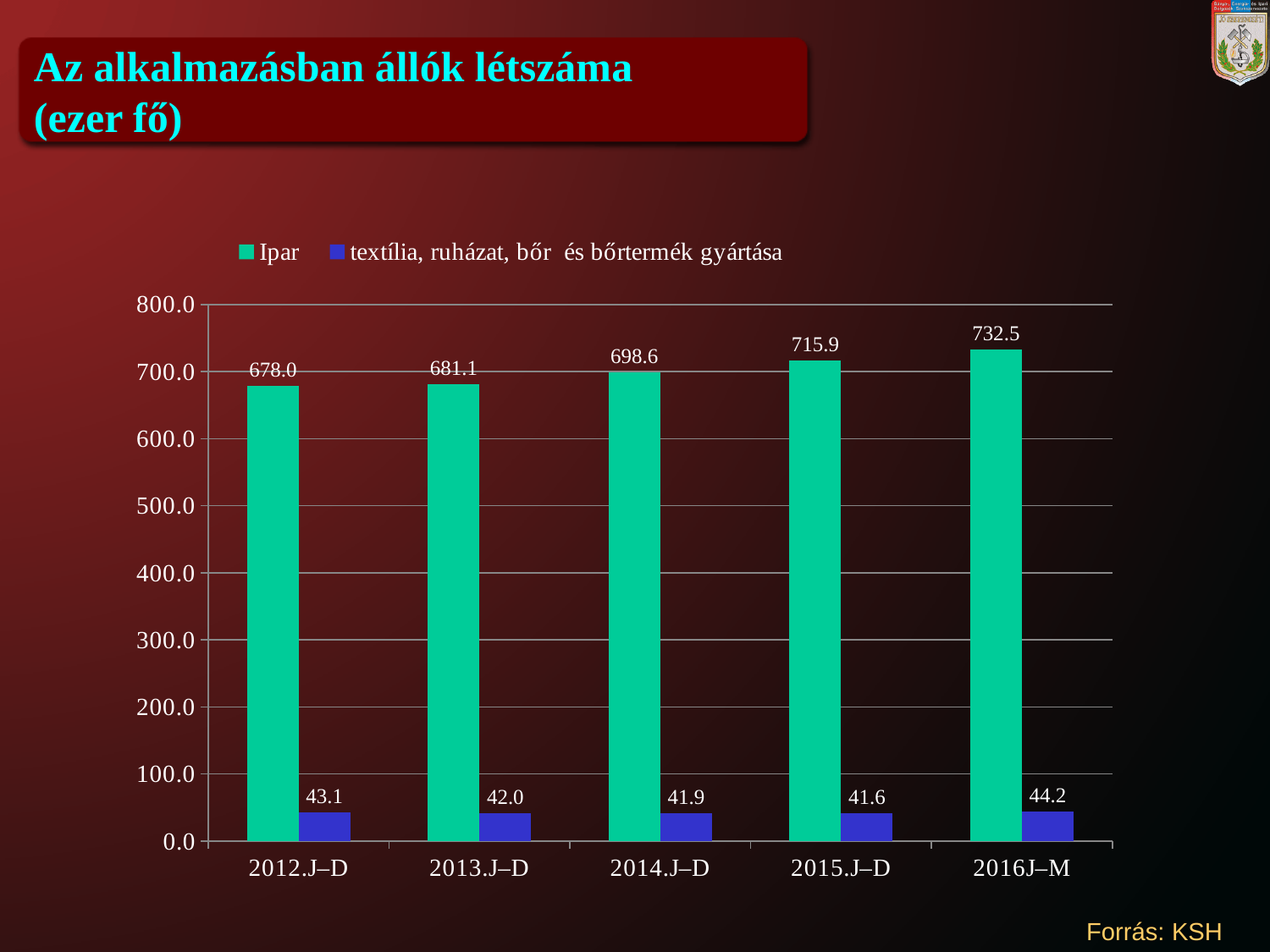
Which is larger, the Ipar value for 2013.J–D or for 2015.J–D? 2015.J–D What kind of chart is shown on the slide? bar chart Do the Ipar values rise or fall from 2012.J–D to 2016J–M? rise In which period is the textília, ruházat, bőr és bőrtermék gyártása value lowest? 2015.J–D In which period is the Ipar value highest? 2016J–M What is the value for Ipar in 2012.J–D? 678.0 How many periods are shown on the x axis? 5 What is the value for textília, ruházat, bőr és bőrtermék gyártása in 2016J–M? 44.2 What is the value for Ipar in 2014.J–D? 698.6 What is the difference between the Ipar values for 2016J–M and 2012.J–D? 54.5 How many series does the legend list? 2 Is the Ipar value for 2015.J–D greater or less than 700.0? greater